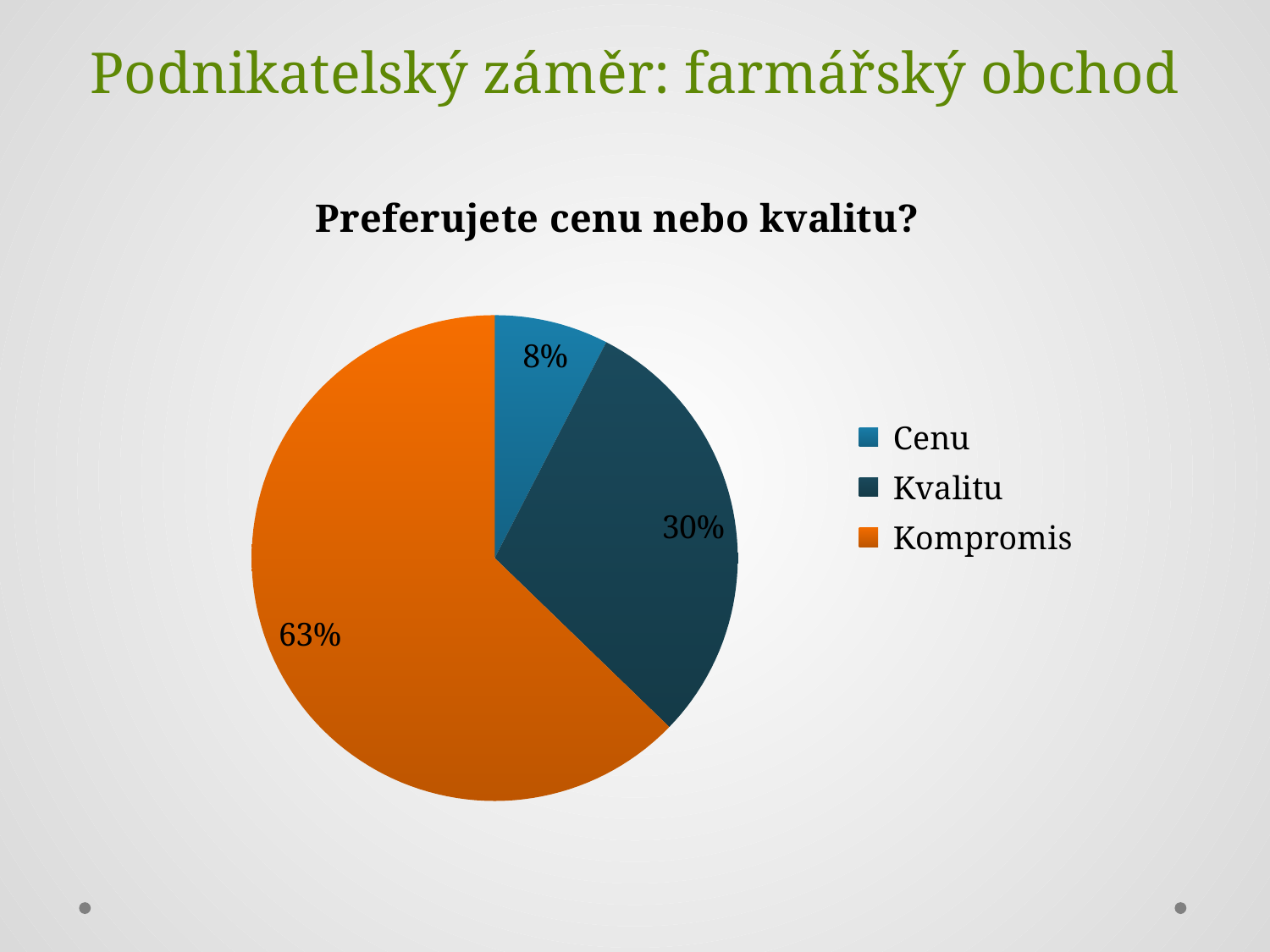
What percentage of the pie is labelled for Kompromis? 63% Which slice is larger, Kvalitu or Cenu? Kvalitu What is the title of the chart? Preferujete cenu nebo kvalitu? What is the difference in percentage points between Kompromis and Kvalitu? 33 What is the difference in percentage points between Kvalitu and Cenu? 22 What colour is the Kompromis slice? orange What kind of chart is shown on the slide? pie chart What percentage of the pie is labelled for Kvalitu? 30% Which category has the largest slice of the pie? Kompromis Which category has the smallest slice of the pie? Cenu How many categories does the pie chart show? 3 What percentage of the pie is labelled for Cenu? 8%